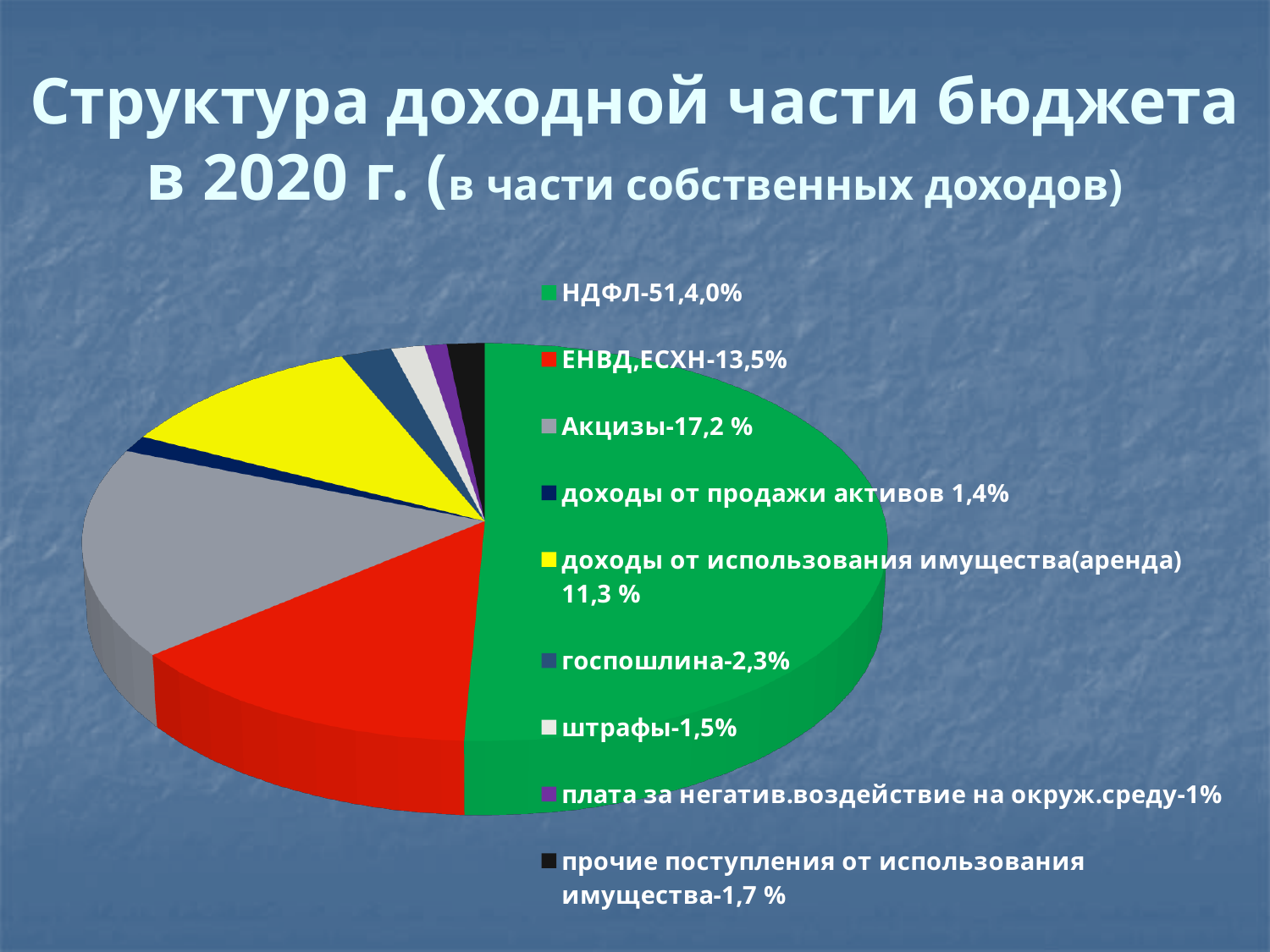
What share is shown for штрафы? 1,5% What share of the budget revenue is attributed to Акцизы according to the legend? 17,2 % What colour is the slice for НДФЛ? green What share is shown for ЕНВД,ЕСХН? 13,5% What share is shown for доходы от использования имущества (аренда)? 11,3 % How many categories does the pie chart's legend list? 9 What kind of chart is shown on the slide? pie chart What is the difference between the share for Акцизы (17,2 %) and the share for ЕНВД,ЕСХН (13,5%)? 3,7 % What share is shown for госпошлина? 2,3% Which category has the largest slice of the pie? НДФЛ Which category has the smallest share in the legend? плата за негатив.воздействие на окруж.среду Which is larger, the share for Акцизы or the share for ЕНВД,ЕСХН? Акцизы